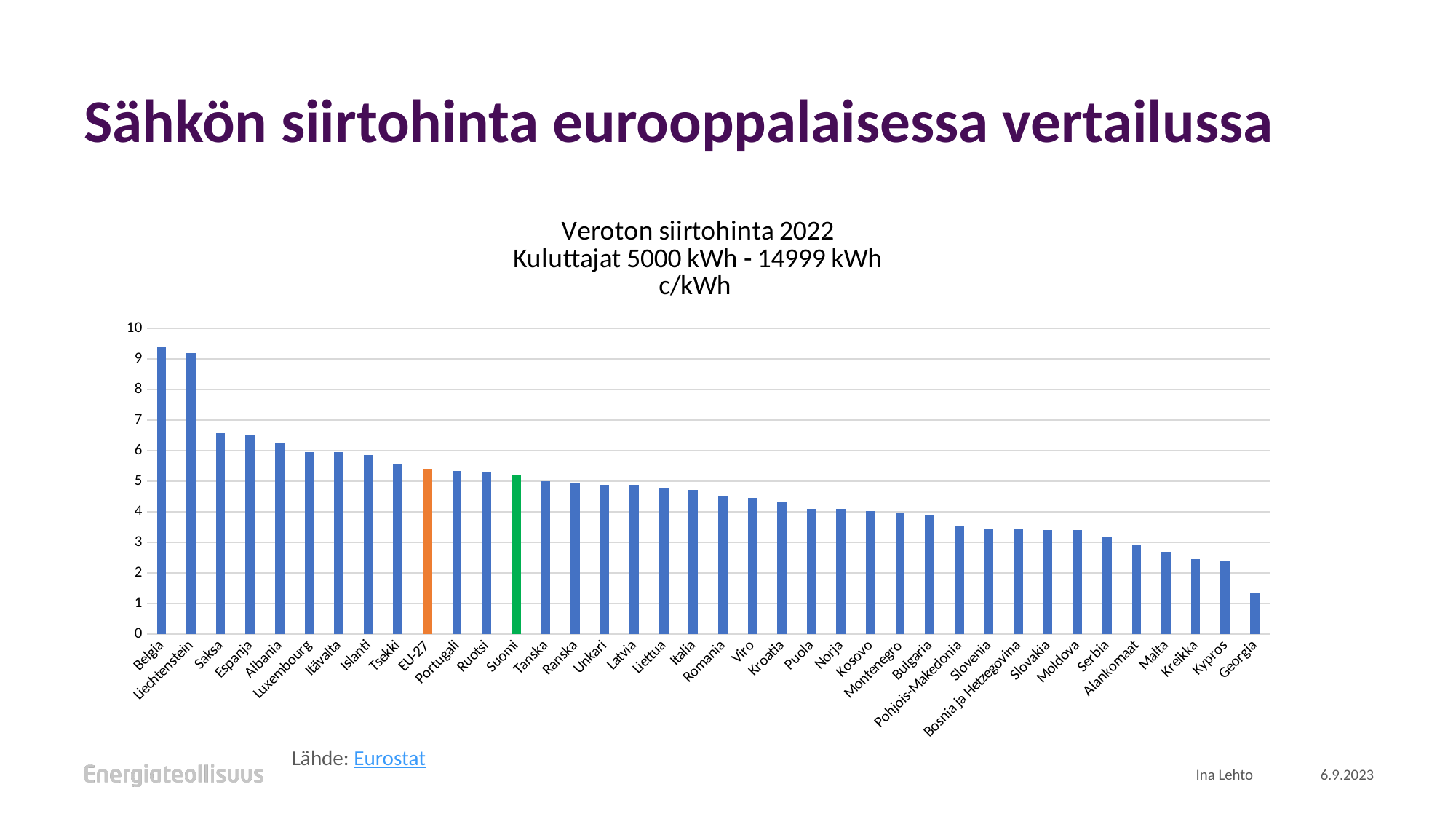
Which bar is coloured green in the chart? Suomi What kind of chart is shown on the slide? bar chart Is the value for Malta greater or less than 3? less How many categories (bars) are shown in the chart? 38 Which country has the highest transmission price in the chart? Belgia Is the value for Georgia greater or less than 2? less Which has a higher value, Saksa or Suomi? Saksa Is the value for Saksa greater or less than 6? greater Which country has the lowest transmission price in the chart? Georgia Do the values rise or fall from left to right along the x axis? fall